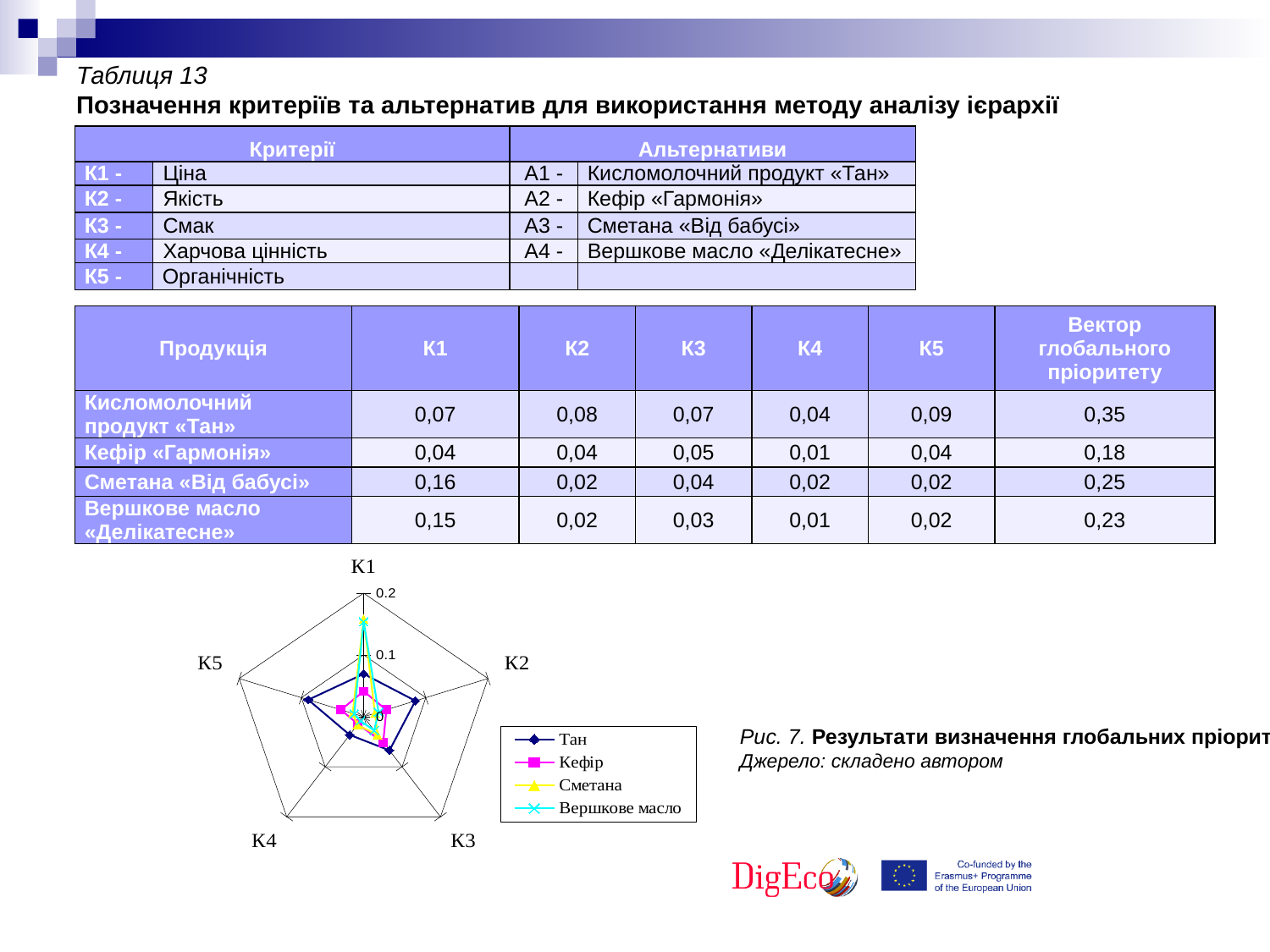
How many criteria axes does the radar chart have? 5 On the radar chart, which has the larger value on axis K1: Сметана or Тан? Сметана On the radar chart, on which axis does the Сметана series reach its highest value? K1 How many series does the legend of the radar chart list? 4 What is the highest tick value shown on the radar chart's axis? 0.2 What kind of chart is shown at the bottom left of the slide? Radar chart On the radar chart, is the value of Сметана on axis K1 greater or less than 0.1? greater On the radar chart, is the value of Кефір on axis K4 greater or less than 0.1? less Which series is listed first in the legend of the radar chart? Тан On the radar chart, which has the larger value on axis K2: Тан or Кефір? Тан On the radar chart, is the value of Тан on axis K1 greater or less than 0.1? less